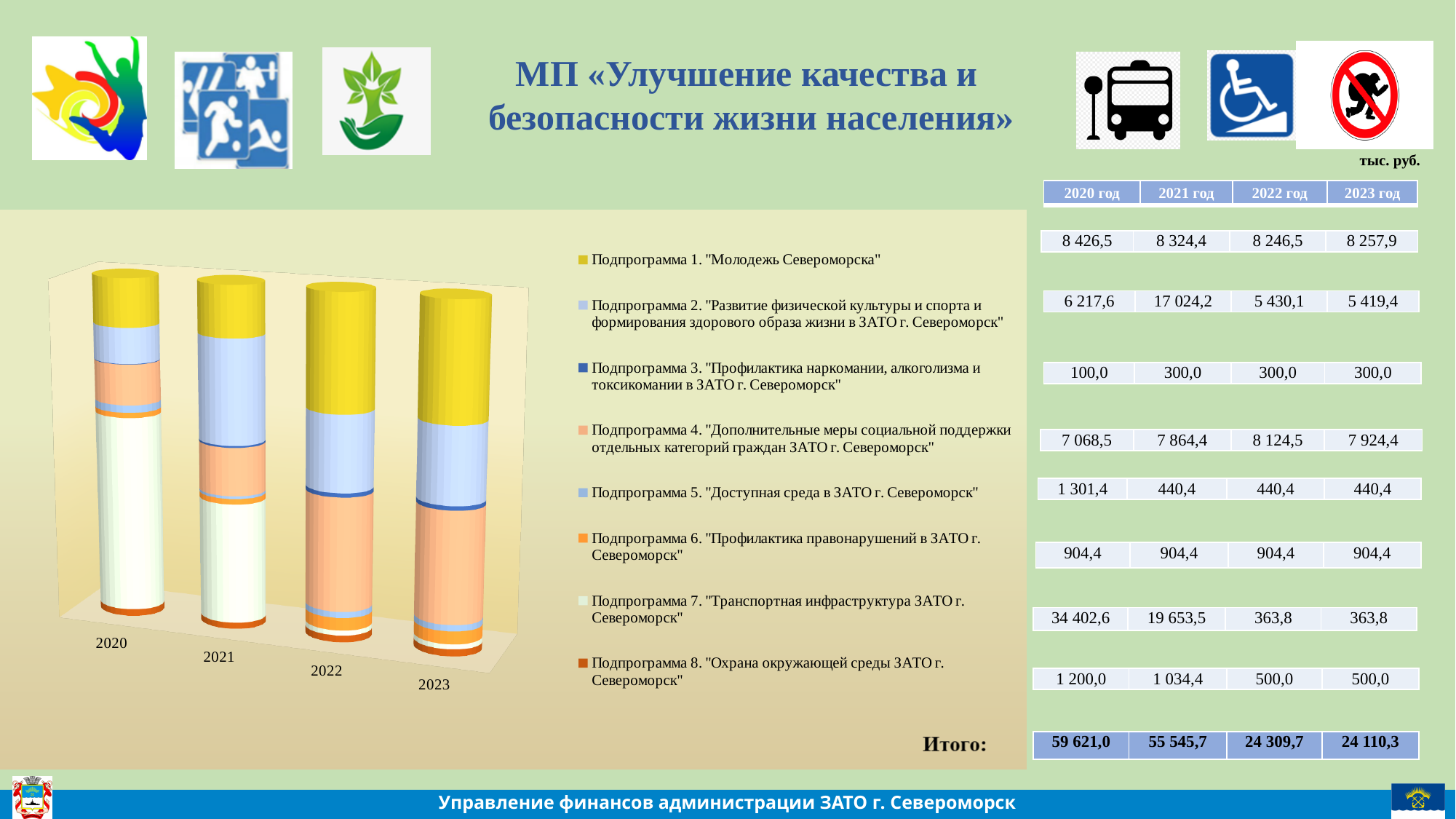
What kind of chart is shown on the slide? Stacked bar chart Which year has the lowest total (Итого)? 2023 год What is the value for Подпрограмма 7 "Транспортная инфраструктура" in 2020 год? 34 402,6 How many subprogrammes (series) does the chart legend list? 8 Which is larger for Подпрограмма 2: the value in 2020 год or in 2021 год? 2021 год In what units are the values in the table given? тыс. руб. Which year has the highest total (Итого)? 2020 год By how much does Подпрограмма 3 increase from 2020 год to 2021 год? 200,0 How many years (categories) are shown along the x axis of the chart? 4 Does the total (Итого) rise or fall from 2020 год to 2023 год? Falls What is the total (Итого) for 2023 год? 24 110,3 What is the value for Подпрограмма 1 "Молодежь Североморска" in 2020 год? 8 426,5